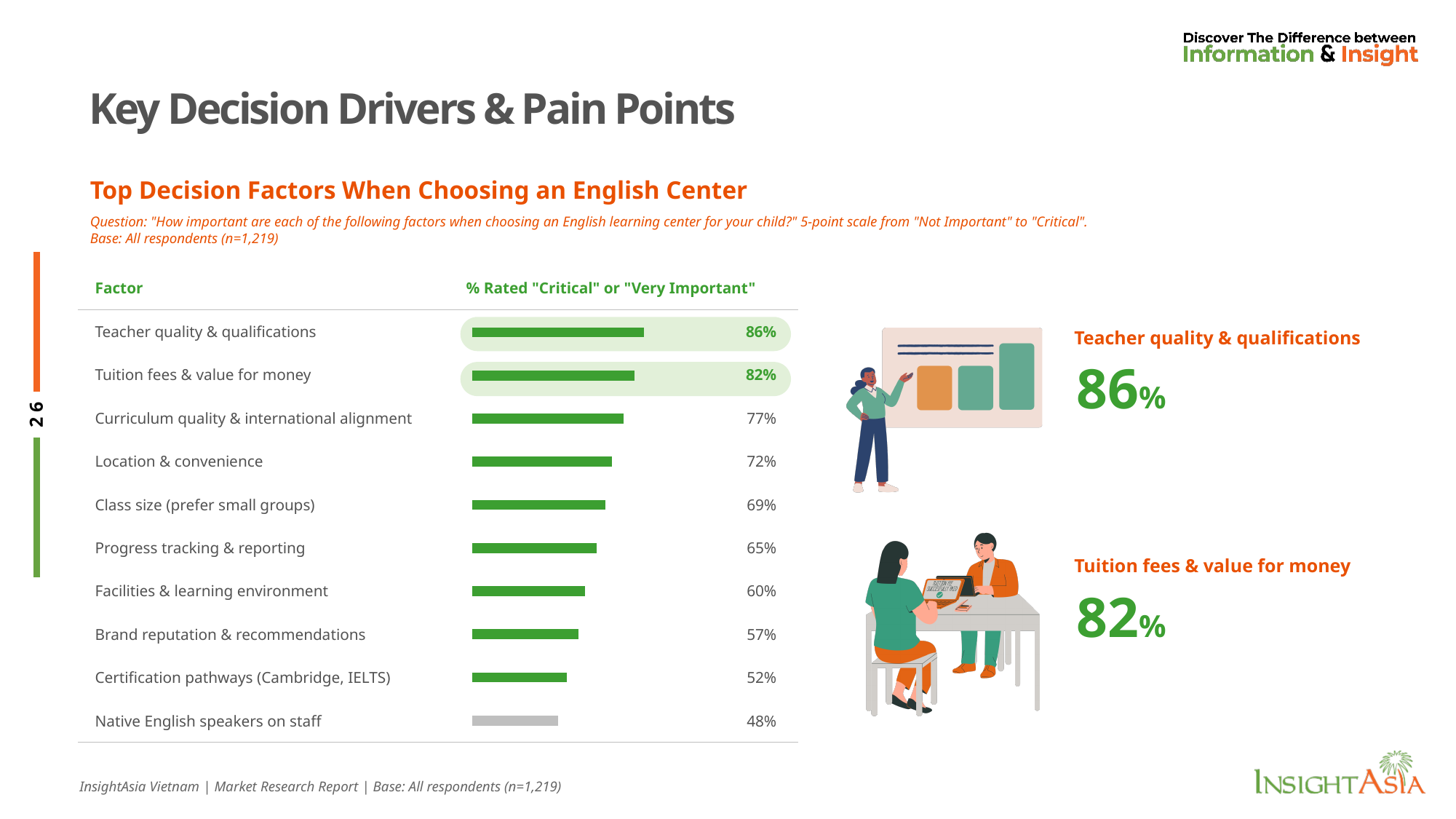
Which has a higher value: Progress tracking & reporting or Facilities & learning environment? Progress tracking & reporting Which factor's bar is shown in grey rather than green? Native English speakers on staff What is the difference in percentage points between Class size (prefer small groups) and Brand reputation & recommendations? 12 Which factor has the lowest percentage rated "Critical" or "Very Important"? Native English speakers on staff What is the value shown for Location & convenience? 72% What is the difference in percentage points between Teacher quality & qualifications and Tuition fees & value for money? 4 What kind of chart is used to show the decision factors? Bar chart How many factors are listed in the chart? 10 Which has a higher value: Curriculum quality & international alignment or Location & convenience? Curriculum quality & international alignment What is the value shown for Certification pathways (Cambridge, IELTS)? 52% Which factor has the highest percentage rated "Critical" or "Very Important"? Teacher quality & qualifications What percentage of respondents rated Teacher quality & qualifications as "Critical" or "Very Important"? 86%